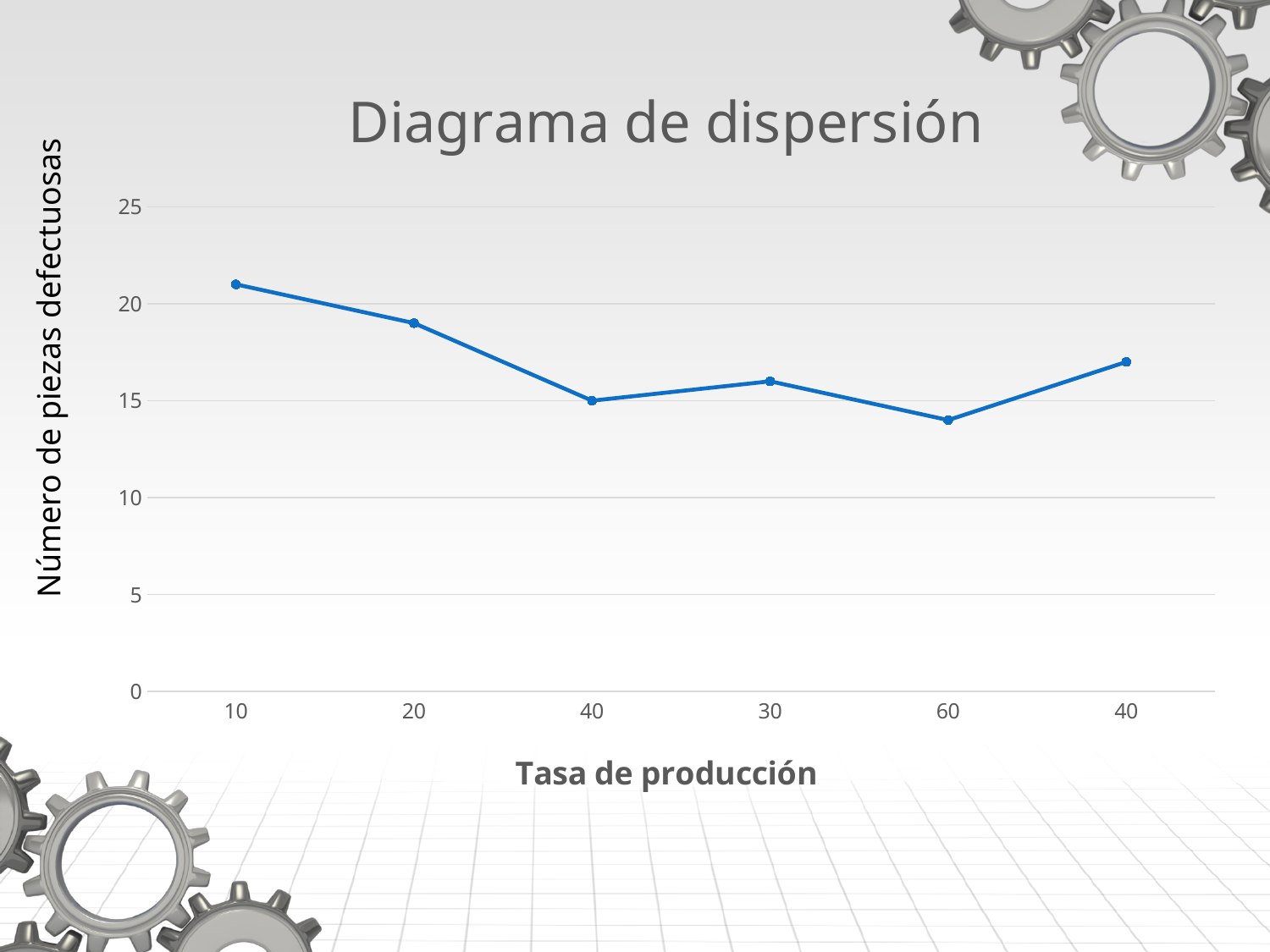
What kind of chart is shown on the slide? line chart Is the value for the category 20 greater or less than 15? greater Do the values rise or fall across the first three points along the x axis (10, 20, 40)? fall What is the label of the x axis? Tasa de producción Is the value for the category 10 greater or less than 20? greater Which x-axis category has the highest number of defective pieces? 10 What is the title of the chart? Diagrama de dispersión How many data points are plotted on the chart? 6 Which has a larger value, the category 10 or the category 20? 10 Which has a larger value, the category 30 or the category 60? 30 Which x-axis category has the lowest number of defective pieces? 60 Is the value for the category 60 greater or less than 15? less